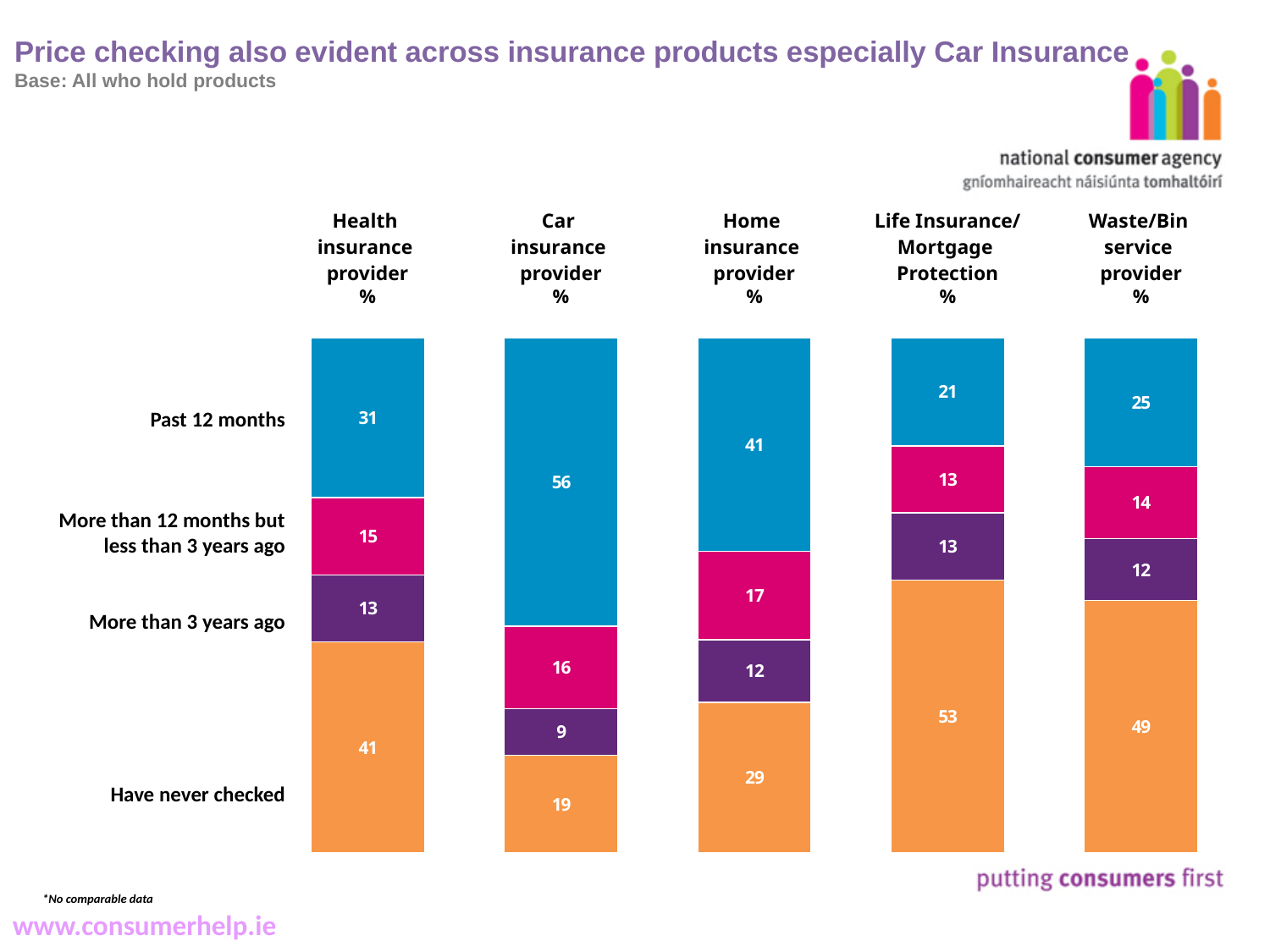
What is the total of the stacked bar for the Car insurance provider? 100 What kind of chart is shown on the slide? Stacked bar chart How many products (bars) are shown in the chart? 5 How many segments (time categories) make up each stacked bar? 4 What is the difference between the 'Past 12 months' values for the Health insurance provider and the Waste/Bin service provider? 6 Which product has the highest percentage for 'Past 12 months'? Car insurance provider What percentage of car insurance provider holders checked prices in the past 12 months? 56 Which product has the lowest percentage for 'Have never checked'? Car insurance provider What colour is used for the 'Have never checked' segment? Orange What is the value for 'More than 3 years ago' for the Waste/Bin service provider? 12 What percentage of Life Insurance/Mortgage Protection holders have never checked prices? 53 Which is larger for 'Past 12 months': the Home insurance provider or the Health insurance provider? Home insurance provider